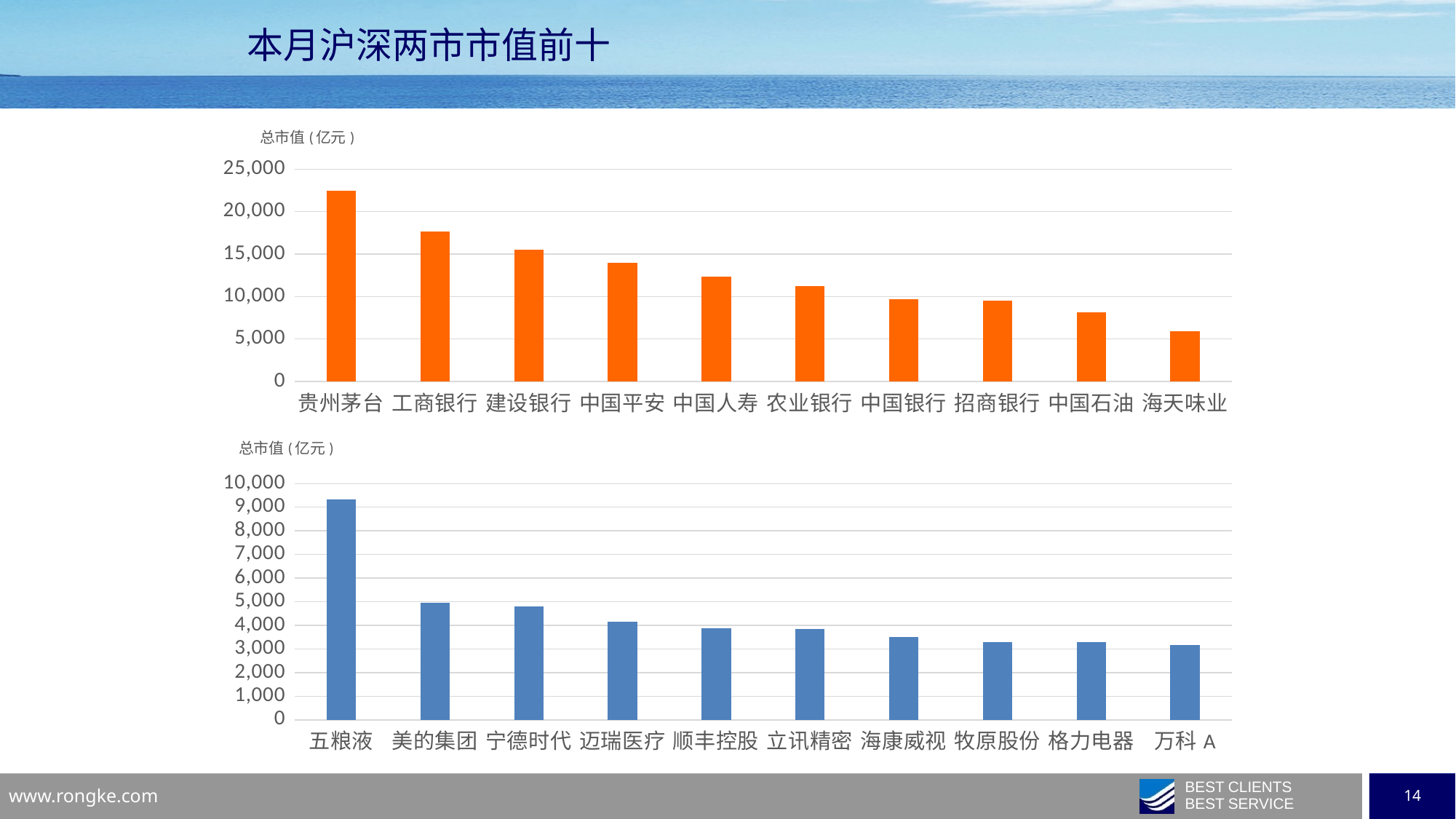
In the top chart, which company has the lowest total market value? 海天味业 In the top chart, which is larger, the value for 工商银行 or the value for 中国平安? 工商银行 In the top chart, is the value for 中国石油 greater or less than 10,000? less In the top chart, which company has the highest total market value? 贵州茅台 In the bottom chart, which company has the highest total market value? 五粮液 In the top chart, is the value for 贵州茅台 greater or less than 20,000? greater In the bottom chart, is the value for 五粮液 greater or less than 9,000? greater What type of chart is the bottom chart? bar chart In the bottom chart, which company has the lowest total market value? 万科 A In the top chart, do the values rise or fall from left to right? fall What is the y-axis label shown on the bottom chart? 总市值（亿元） In the top chart, how many companies are shown? 10